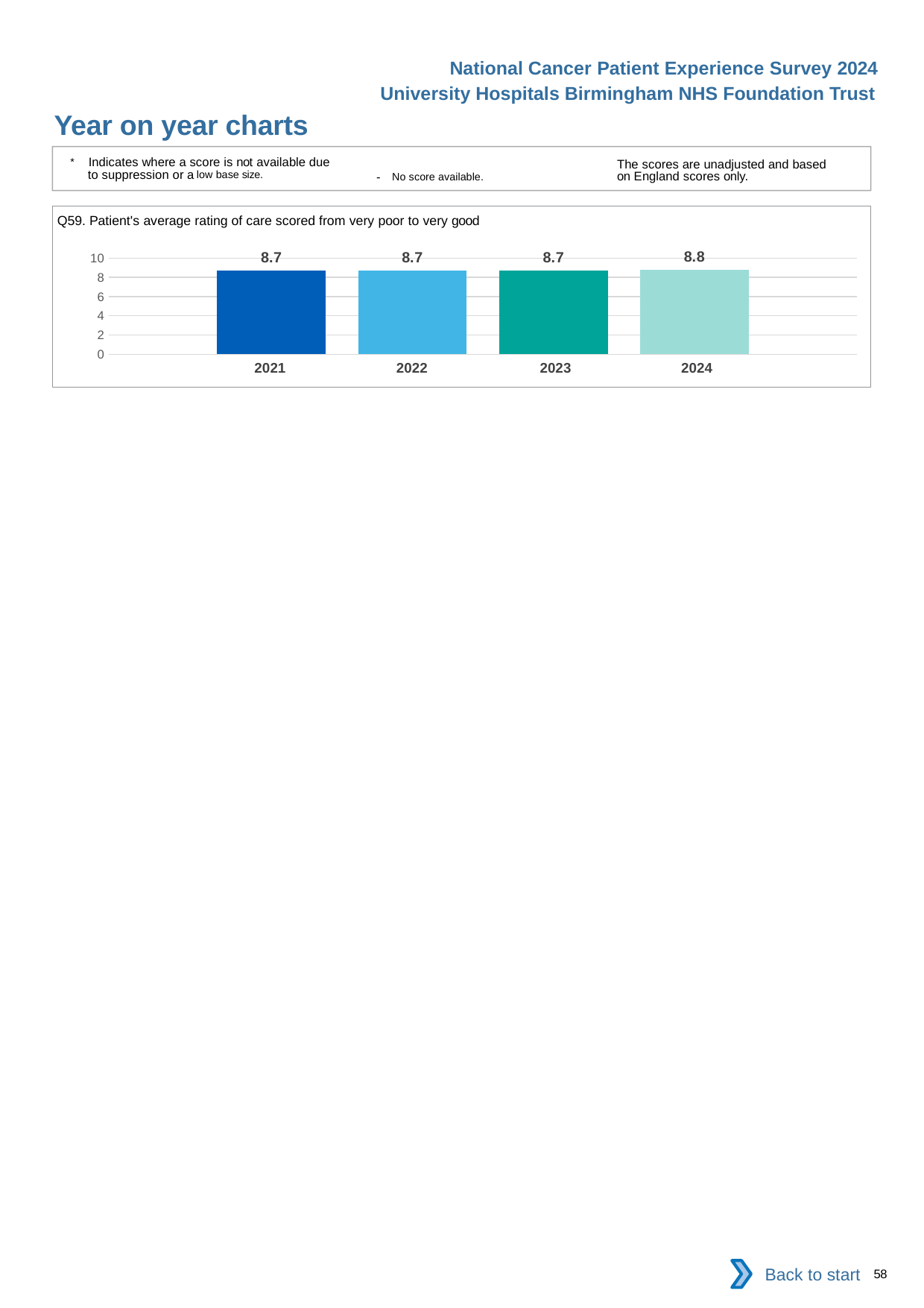
What is the value for 2021? 8.7 How many years are shown on the x axis? 4 Do the values rise or fall from 2023 to 2024? rise What is the highest value shown on the y axis? 10 What is the difference between the values for 2024 and 2022? 0.1 Which year has the highest value? 2024 What kind of chart is this? bar chart What is the title of the chart? Q59. Patient's average rating of care scored from very poor to very good What is the value for 2024? 8.8 What is the value for 2023? 8.7 Is the value for 2022 greater or less than 8? greater